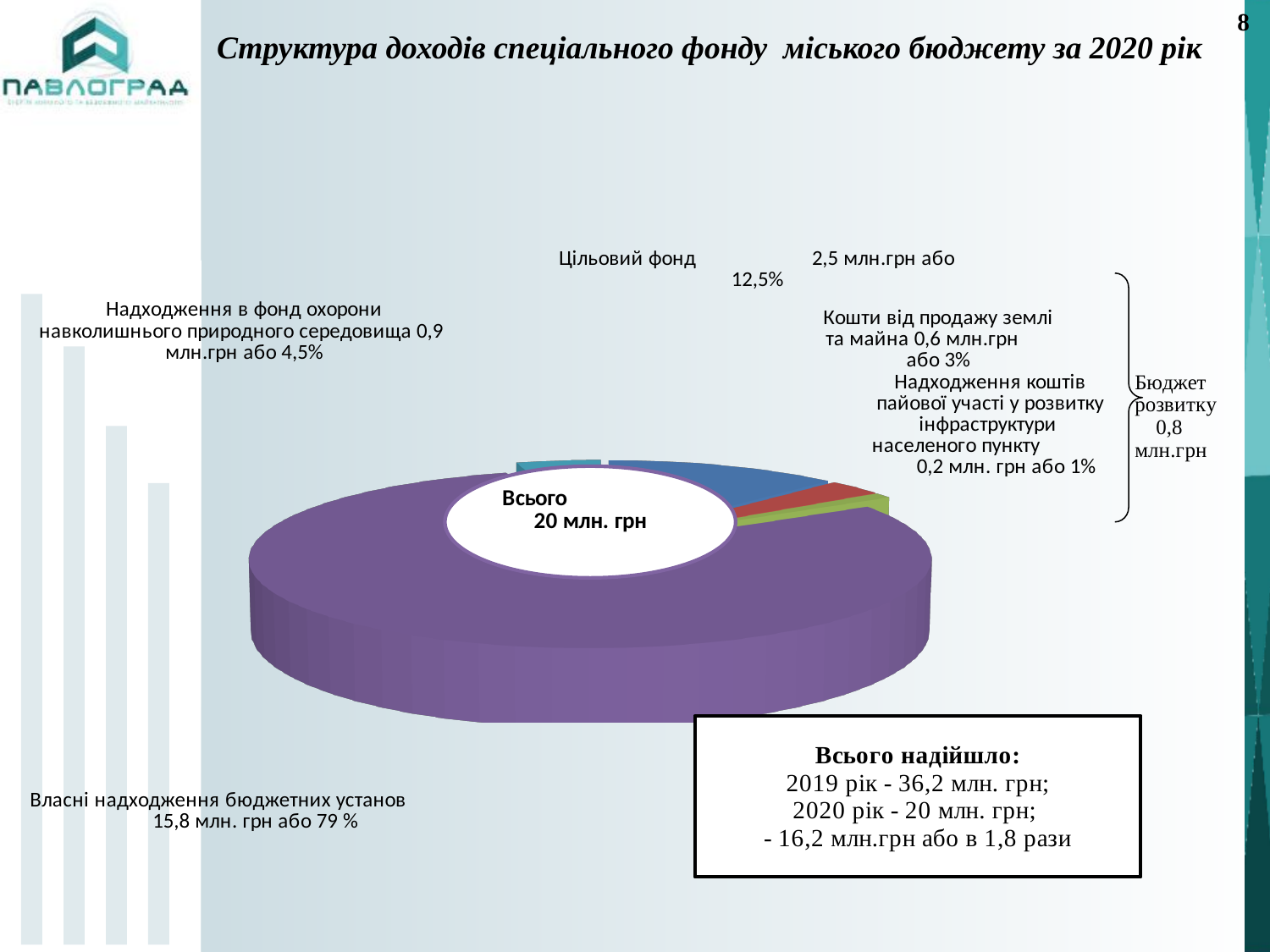
What share of the pie does Кошти від продажу землі та майна represent? 3% What is the value for Цільовий фонд? 2,5 млн.грн Which category has the largest slice of the pie? Власні надходження бюджетних установ What share of the pie does Власні надходження бюджетних установ represent? 79 % What share of the pie does Цільовий фонд represent? 12,5% What is the value for Надходження в фонд охорони навколишнього природного середовища? 0,9 млн.грн How many categories are shown in the pie chart? 5 What is the title of the chart on the slide? Структура доходів спеціального фонду міського бюджету за 2020 рік What is the total value shown in the centre of the pie chart? 20 млн. грн What kind of chart is shown on the slide? Pie chart What is the value for Власні надходження бюджетних установ? 15,8 млн. грн Which category has the smallest slice of the pie? Надходження коштів пайової участі у розвитку інфраструктури населеного пункту